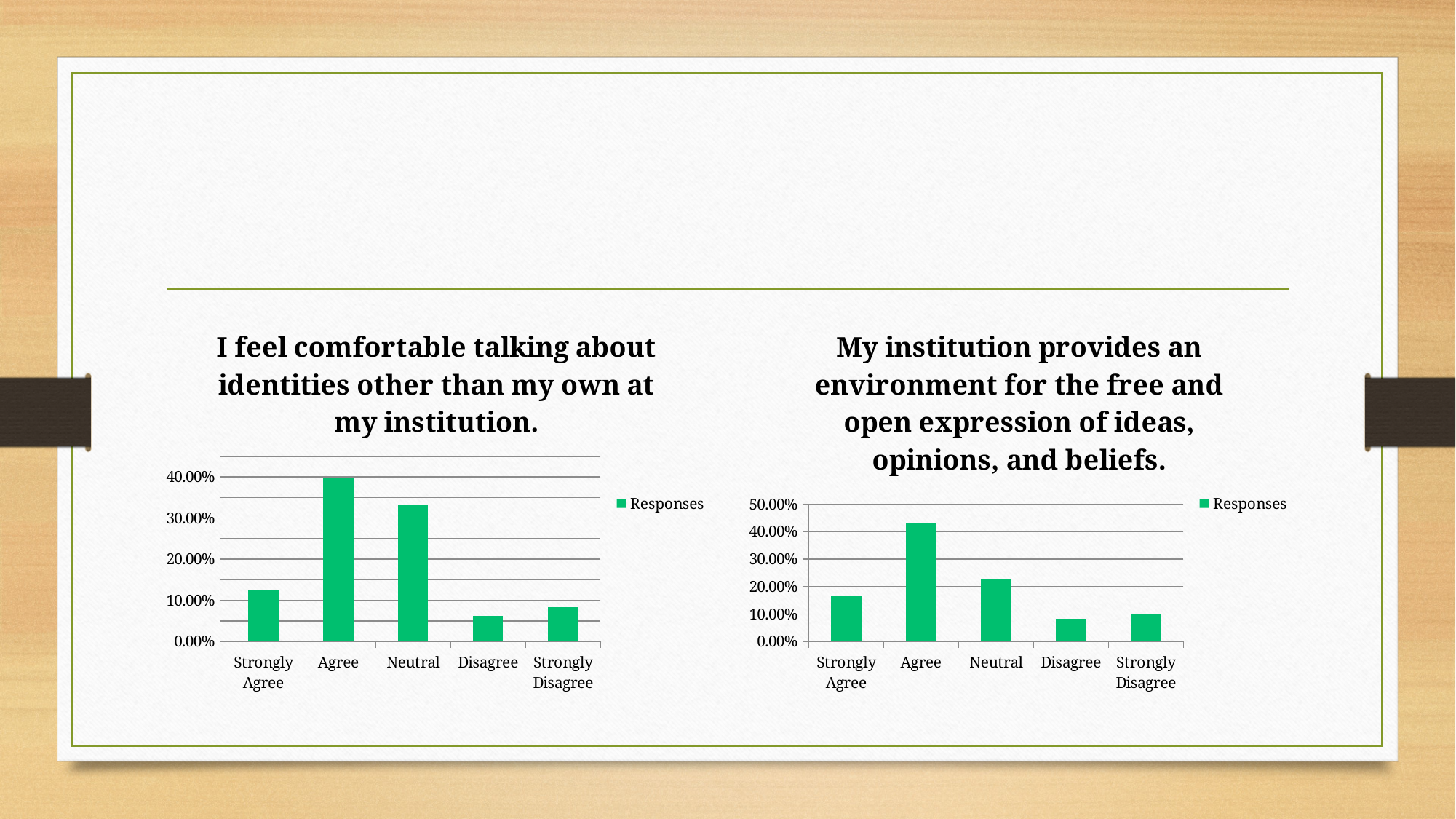
In the left chart titled "I feel comfortable talking about identities other than my own at my institution.", which category has the highest value? Agree In the right chart titled "My institution provides an environment for the free and open expression of ideas, opinions, and beliefs.", which category has the highest value? Agree How many categories are shown on the x axis of the right chart titled "My institution provides an environment for the free and open expression of ideas, opinions, and beliefs."? 5 How many series does the legend of the left chart titled "I feel comfortable talking about identities other than my own at my institution." list? 1 What kind of chart is the right chart titled "My institution provides an environment for the free and open expression of ideas, opinions, and beliefs."? bar chart In the right chart titled "My institution provides an environment for the free and open expression of ideas, opinions, and beliefs.", which category has the lowest value? Disagree In the left chart titled "I feel comfortable talking about identities other than my own at my institution.", which is larger, Neutral or Strongly Agree? Neutral In the right chart titled "My institution provides an environment for the free and open expression of ideas, opinions, and beliefs.", which is larger, Neutral or Strongly Agree? Neutral In the left chart titled "I feel comfortable talking about identities other than my own at my institution.", which category has the lowest value? Disagree In the left chart titled "I feel comfortable talking about identities other than my own at my institution.", is the value for Strongly Agree greater or less than 20.00%? less In the right chart titled "My institution provides an environment for the free and open expression of ideas, opinions, and beliefs.", is the value for Agree greater or less than 40.00%? greater In the left chart titled "I feel comfortable talking about identities other than my own at my institution.", is the value for Agree greater or less than 30.00%? greater